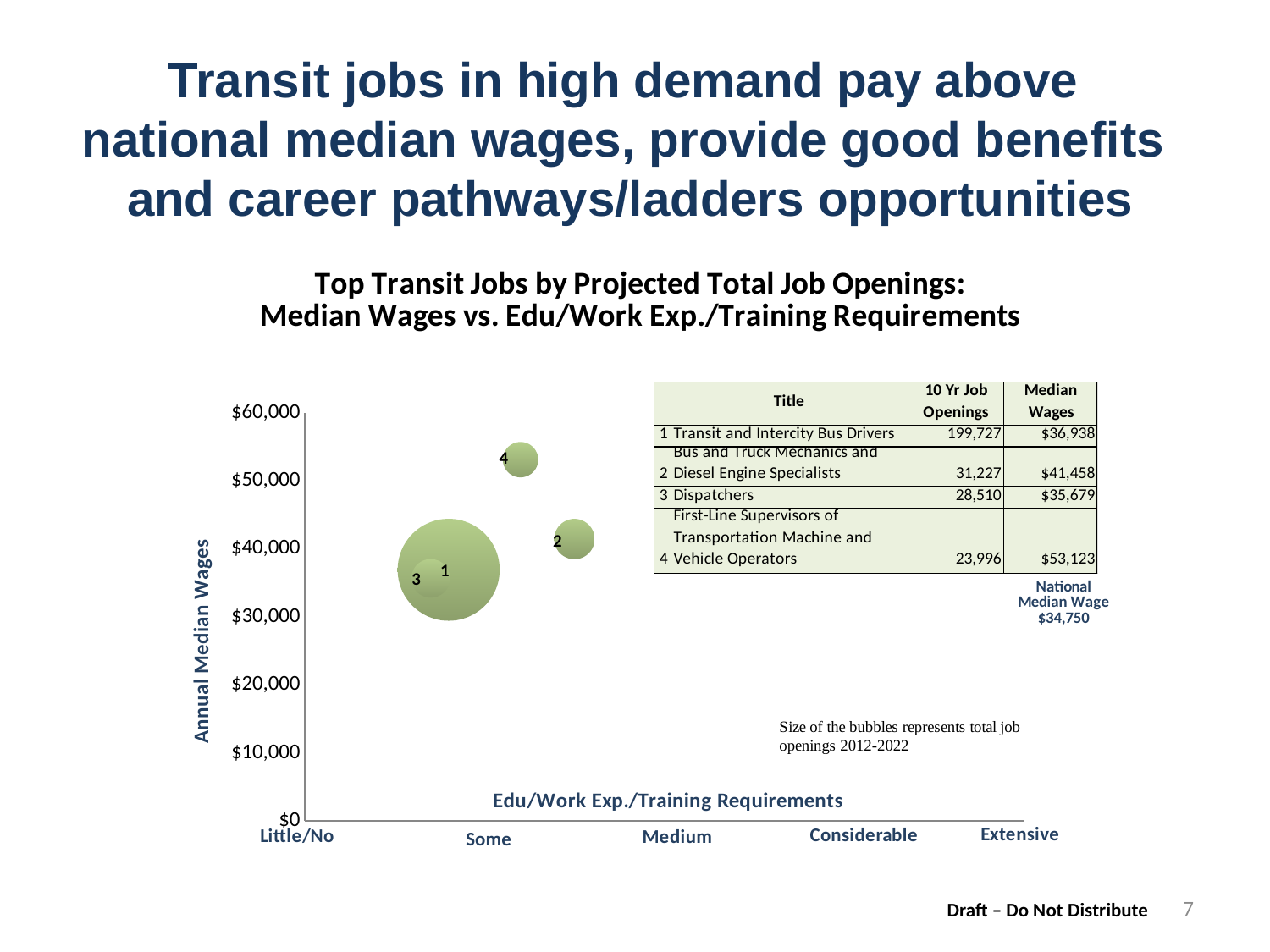
What value does the dashed National Median Wage line represent? $34,750 How many 10-year job openings are listed for First-Line Supervisors of Transportation Machine and Vehicle Operators? 23,996 What kind of chart is shown on the slide? Bubble chart Which job has the most 10-year job openings? Transit and Intercity Bus Drivers How many bubbles (jobs) are plotted on the chart? 4 Is the median wage for bubble 4 greater or less than $50,000? greater Which job has the highest median wage? First-Line Supervisors of Transportation Machine and Vehicle Operators Which has a higher median wage: Bus and Truck Mechanics and Diesel Engine Specialists or Transit and Intercity Bus Drivers? Bus and Truck Mechanics and Diesel Engine Specialists Which job has the lowest median wage? Dispatchers What is the difference in median wages between Bus and Truck Mechanics and Diesel Engine Specialists and Dispatchers? $5,779 What is the median wage for Dispatchers? $35,679 How many 10-year job openings are listed for Transit and Intercity Bus Drivers? 199,727